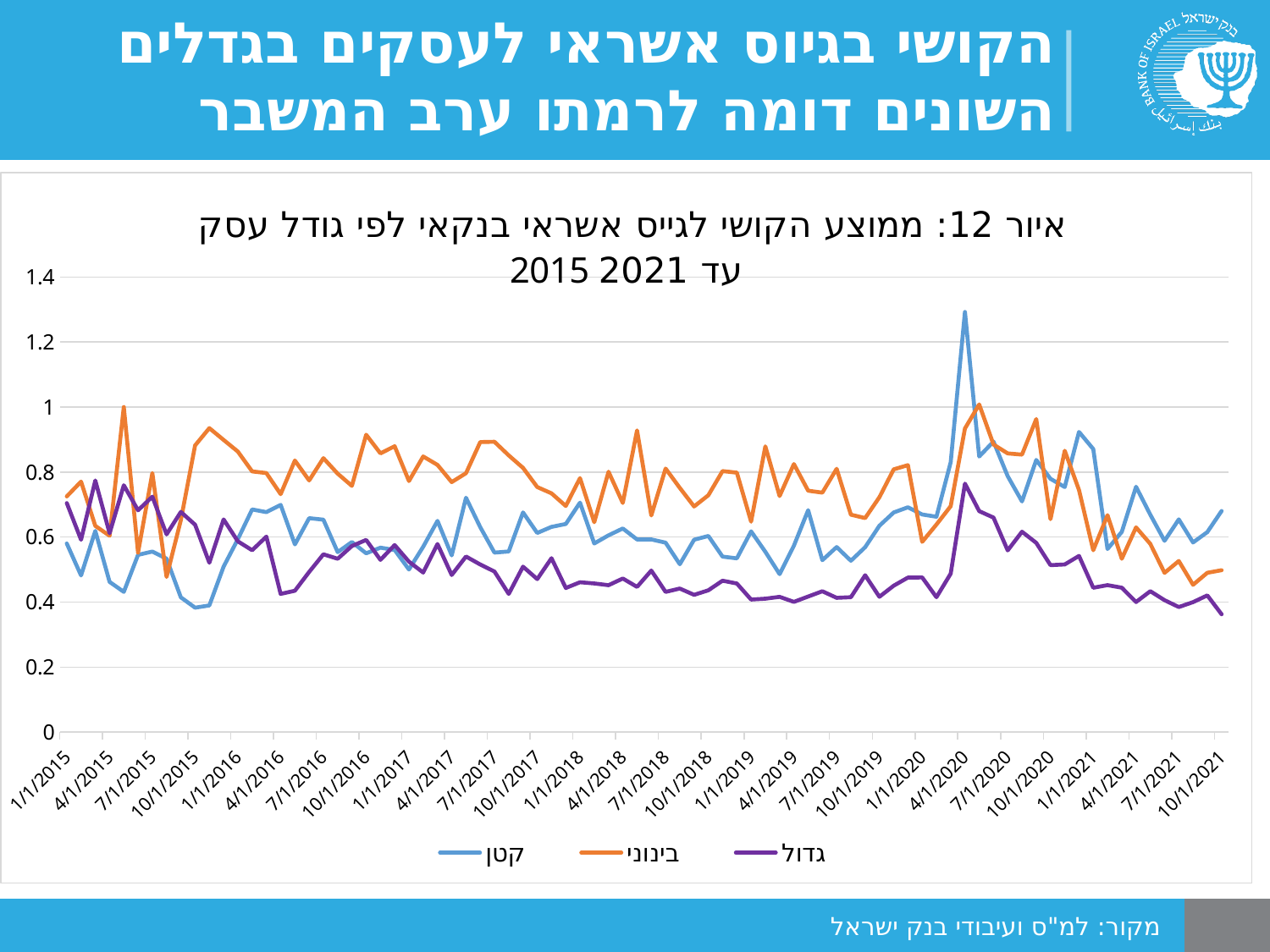
Which series reaches the highest value anywhere on the chart? קטן Is the value of the קטן series at 10/1/2015 greater or less than 0.6? less Does the גדול series rise or fall between 4/1/2020 and 10/1/2021? fall How many series does the legend list? 3 Is the value of the גדול series at 4/1/2020 greater or less than 0.6? greater What are the three series named in the legend? קטן, בינוני, גדול Is the value of the קטן series at 4/1/2020 greater or less than 1.2? greater What kind of chart is shown on the slide? line chart At 1/1/2017, which series has the larger value, בינוני or גדול? בינוני Which series has the lowest value at the last date, 10/1/2021? גדול What is the highest tick value shown on the vertical axis? 1.4